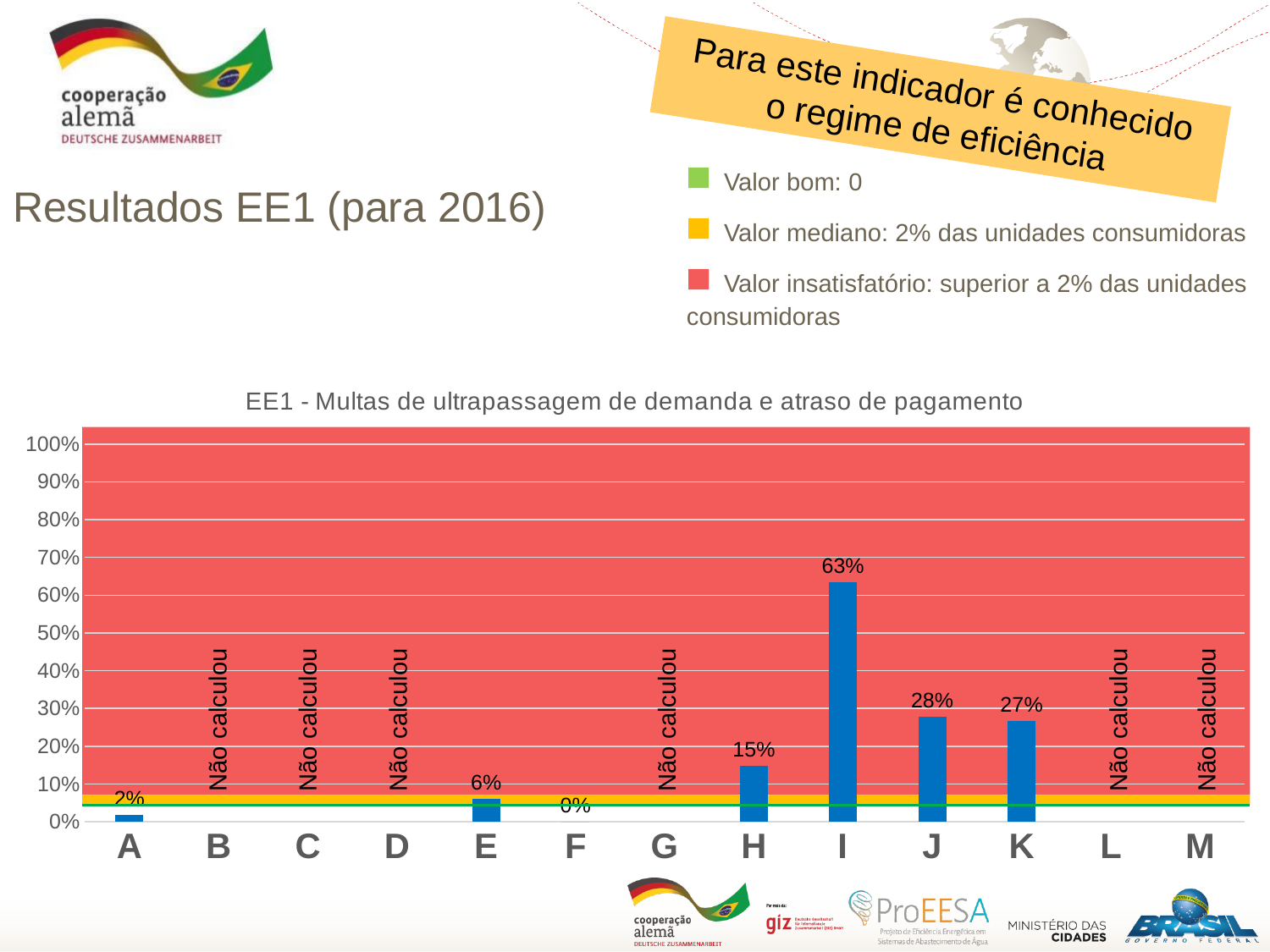
What is the value for category H? 15% What is the value for category I? 63% Is the value for I greater or less than 50%? greater Which category has the highest value? I Which is larger, the value for J or the value for K? J How many categories are shown on the x axis? 13 What is the value for category E? 6% What is the title of the chart? EE1 - Multas de ultrapassagem de demanda e atraso de pagamento Among the categories with a calculated value, which has the lowest value? F What is the difference between the values for I and J? 35% What kind of chart is this? bar chart What is the value for category A? 2%